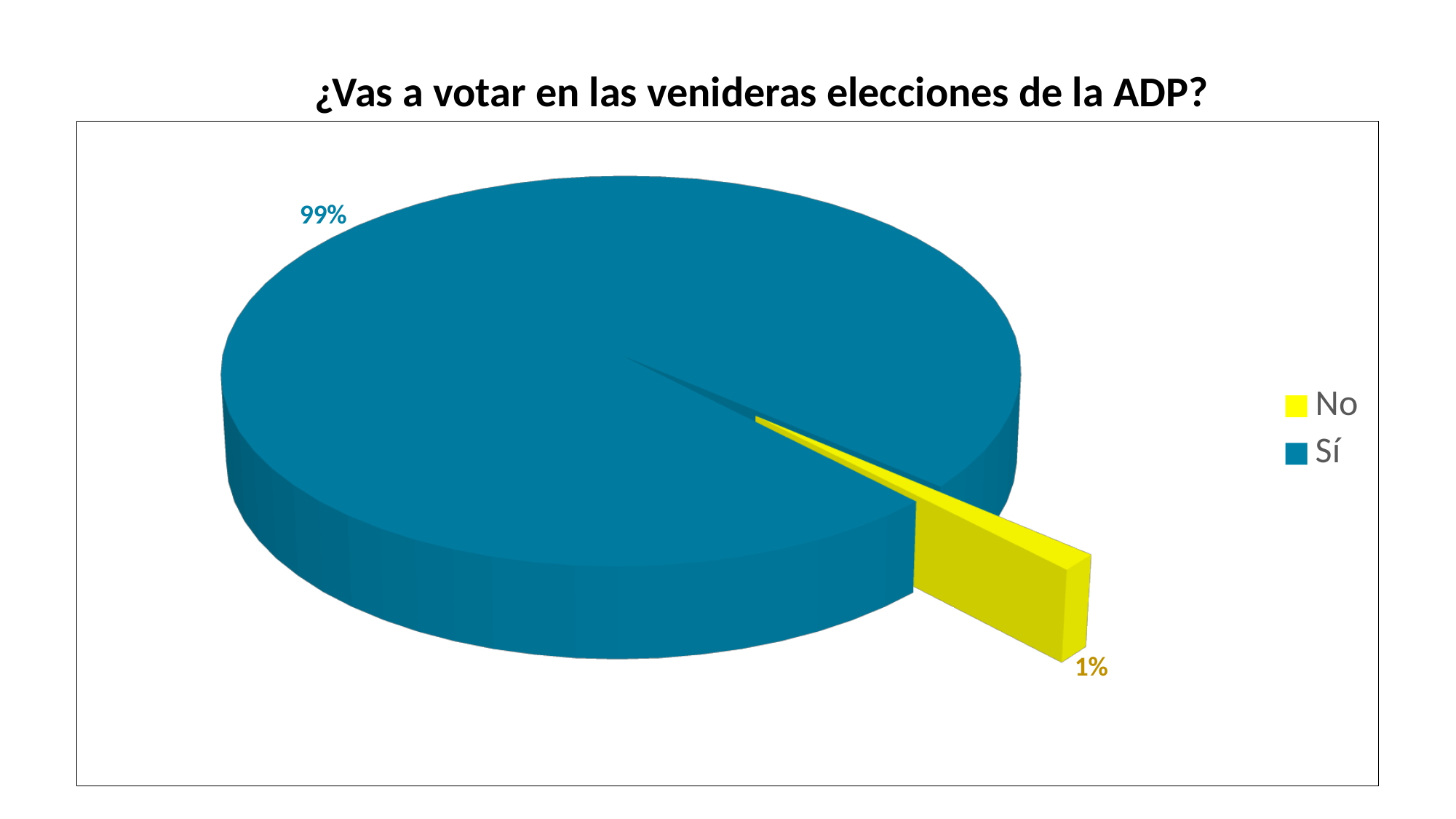
Which category has the largest slice of the pie? Sí What share of the pie does the "Sí" slice represent? 99% What is the difference in percentage points between the "Sí" and "No" slices? 98 What share of the pie does the "No" slice represent? 1% What kind of chart is shown on the slide? Pie chart What colour is the "No" slice in the pie chart? Yellow How many entries does the legend list? 2 What is the title of the chart? ¿Vas a votar en las venideras elecciones de la ADP? Which is larger, the "Sí" slice or the "No" slice? Sí Which category has the smallest slice of the pie? No How many categories are shown in the pie chart? 2